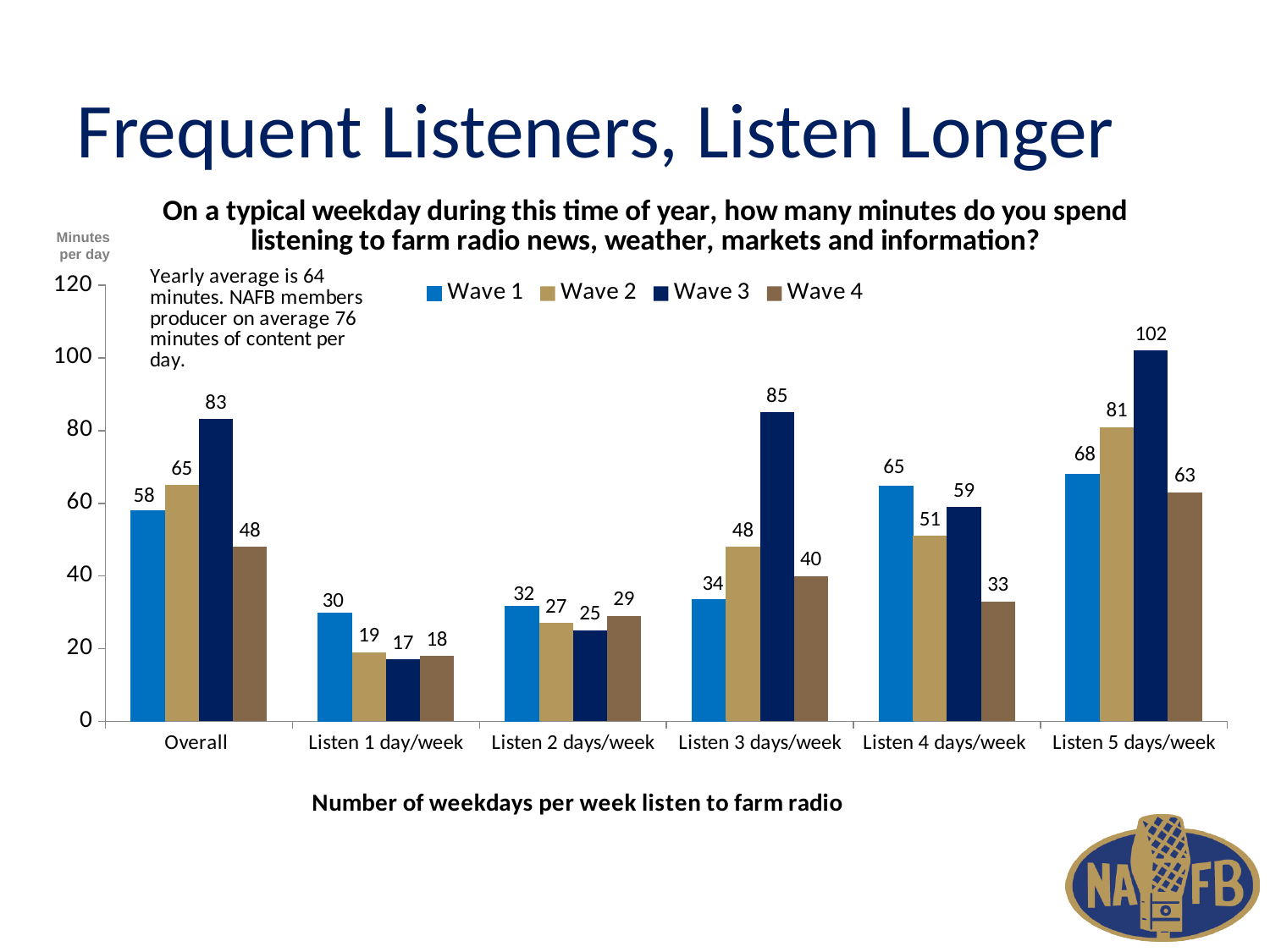
Do the Wave 2 values rise or fall from Listen 1 day/week to Listen 5 days/week? rise Which is larger for Listen 4 days/week: Wave 1 or Wave 3? Wave 1 What is the x-axis label of the chart? Number of weekdays per week listen to farm radio What is the Wave 1 value for the Overall category? 58 What kind of chart is shown on the slide? bar chart Which category has the lowest Wave 2 value? Listen 1 day/week Which category has the highest Wave 3 value? Listen 5 days/week How many series does the legend list? 4 What is the Wave 3 value for Listen 5 days/week? 102 What is the difference between the Wave 3 and Wave 4 values for Listen 5 days/week? 39 How many categories are shown on the x axis? 6 What is the Wave 4 value for Listen 3 days/week? 40